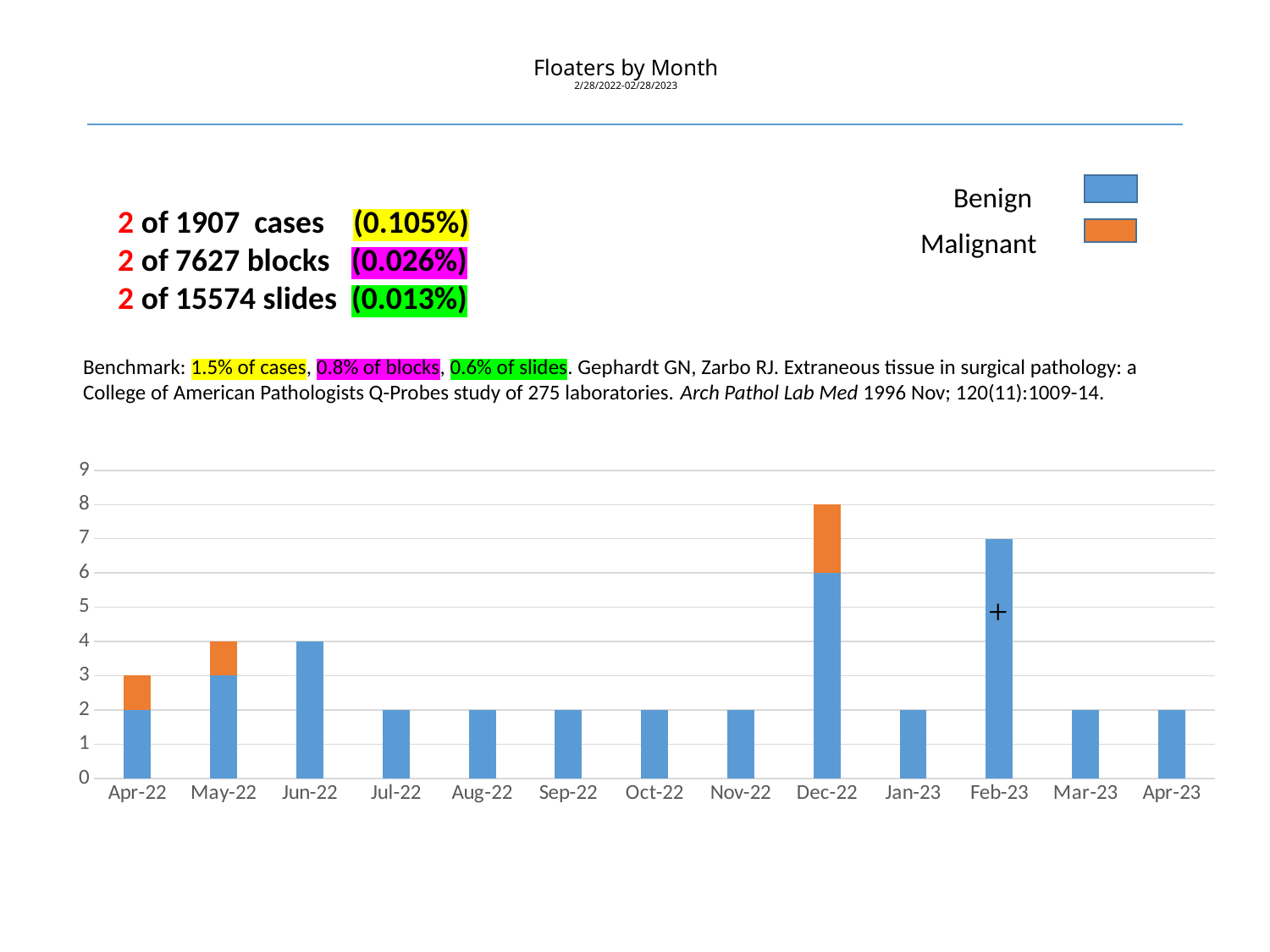
What is the Benign value for Dec-22? 6 What is the total value for Jun-22? 4 How many series does the legend list? 2 How many months are shown on the x axis of the chart? 13 Which is larger, the total bar for Dec-22 or for Feb-23? Dec-22 What is the total value for Feb-23? 7 Is the value for Feb-23 greater or less than 5? greater Which month has the highest total bar? Dec-22 What is the difference between the total bars for Dec-22 and Feb-23? 1 What is the title of the chart? Floaters by Month What kind of chart is shown on the slide? Stacked bar chart What is the total height of the stacked bar for Dec-22? 8